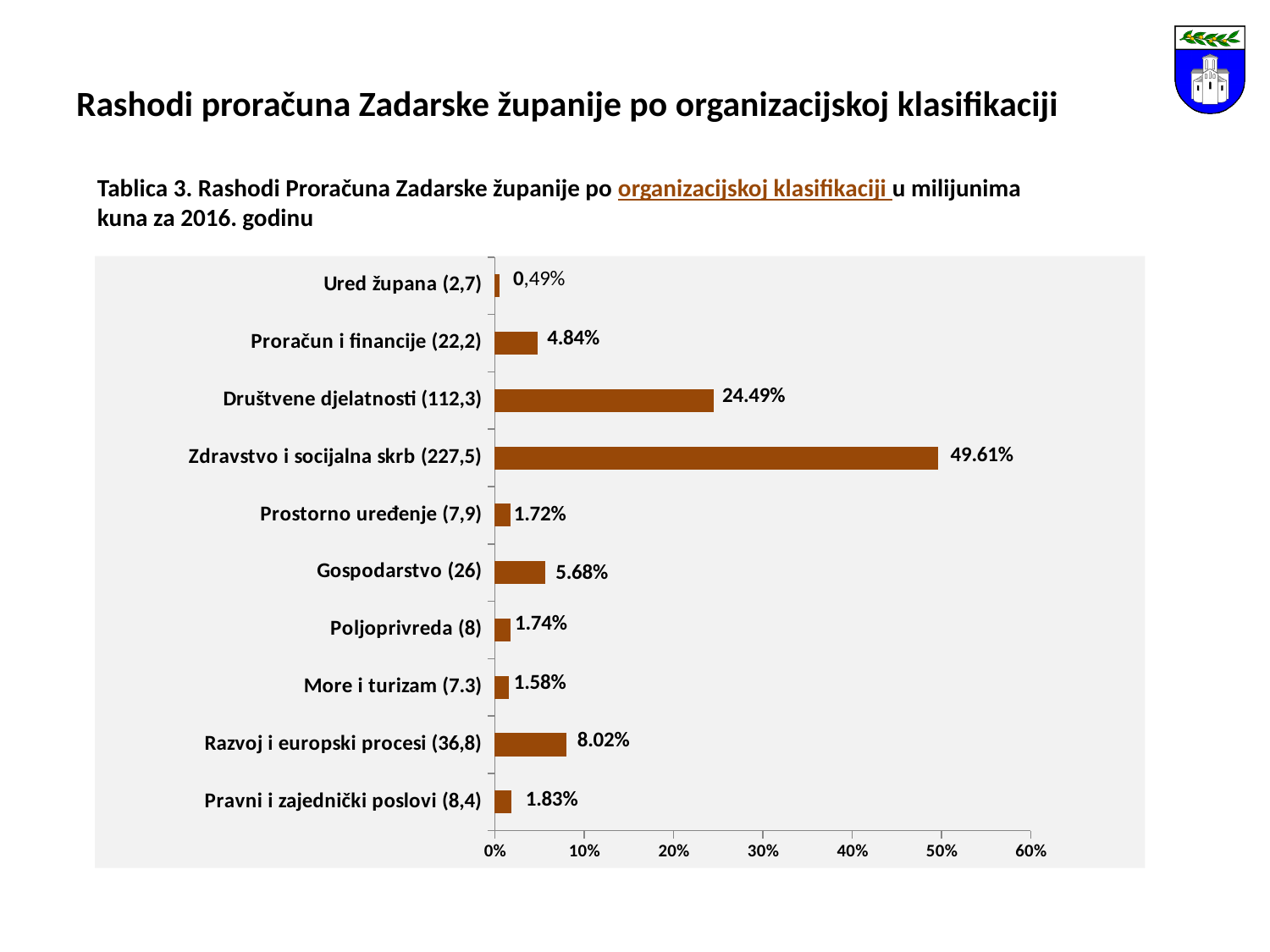
Is the value for Zdravstvo i socijalna skrb (227,5) greater or less than 40%? greater What is the value shown for Zdravstvo i socijalna skrb (227,5)? 49.61% What is the value shown for Ured župana (2,7)? 0,49% Which category has the lowest value? Ured župana (2,7) Which is larger, the value for Gospodarstvo (26) or the value for Proračun i financije (22,2)? Gospodarstvo (26) What is the difference between the values for Zdravstvo i socijalna skrb (227,5) and Društvene djelatnosti (112,3)? 25.12% What is the value shown for Društvene djelatnosti (112,3)? 24.49% What is the value shown for Razvoj i europski procesi (36,8)? 8.02% What is the highest value shown on the horizontal axis? 60% What kind of chart is shown on the slide? bar chart How many categories are shown in the chart? 10 Which category has the highest value? Zdravstvo i socijalna skrb (227,5)